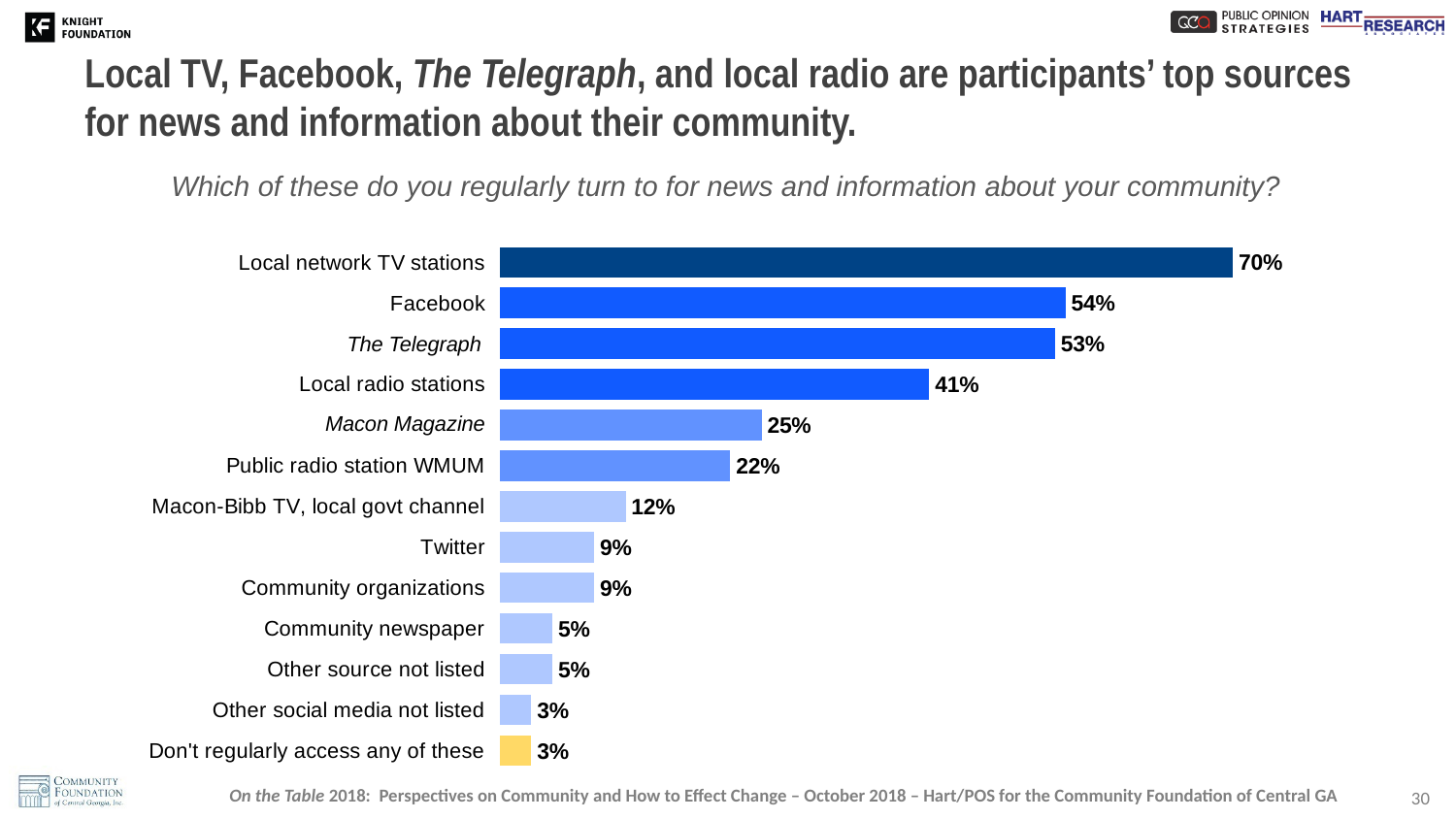
What is the value shown for Macon-Bibb TV, local govt channel? 12% What is the value shown for Facebook? 54% What percentage of participants regularly turn to local network TV stations for news about their community? 70% Which source has the highest percentage in the chart? Local network TV stations Which has a higher value, Macon Magazine or Public radio station WMUM? Macon Magazine What is the difference in percentage points between Facebook and The Telegraph? 1 What percentage of participants regularly turn to Public radio station WMUM? 22% Which has a higher value, Local radio stations or Macon Magazine? Local radio stations How many categories (sources) are shown in the chart? 13 What is the value shown for Twitter? 9% What kind of chart is shown on the slide? Bar chart What is the difference in percentage points between Local network TV stations and Local radio stations? 29